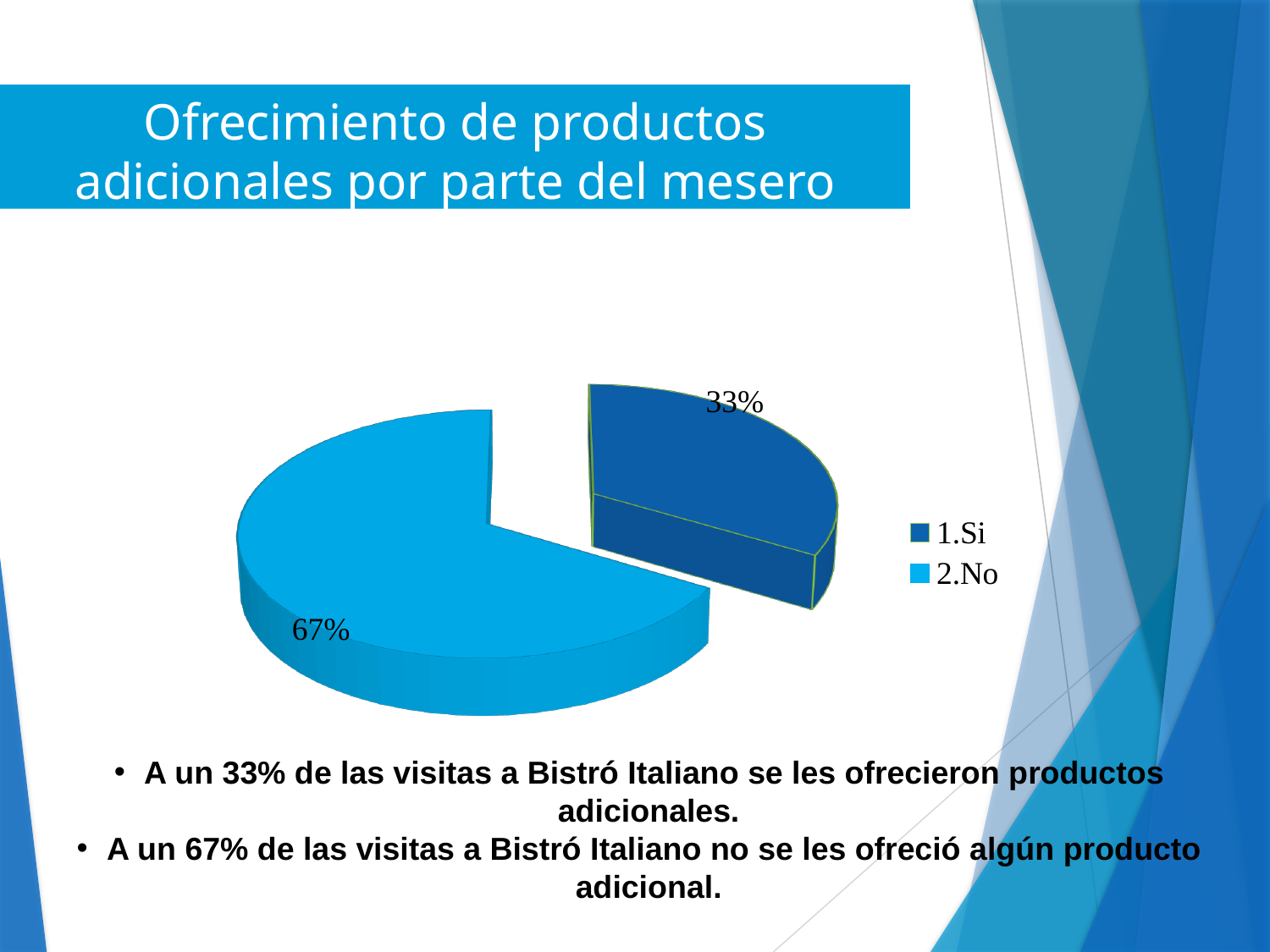
What share of the pie does the "2.No" slice represent? 67% Which slice of the pie is the largest? 2.No What share of the pie does the "1.Si" slice represent? 33% Which is larger, the "1.Si" slice or the "2.No" slice? 2.No Which legend entry is shown in the lighter blue colour? 2.No What is the title shown above the chart on the slide? Ofrecimiento de productos adicionales por parte del mesero Which slice of the pie is the smallest? 1.Si What is the difference in percentage points between the "2.No" slice and the "1.Si" slice? 34% How many entries does the legend list? 2 How many slices does the pie chart have? 2 What kind of chart is shown on the slide? pie chart